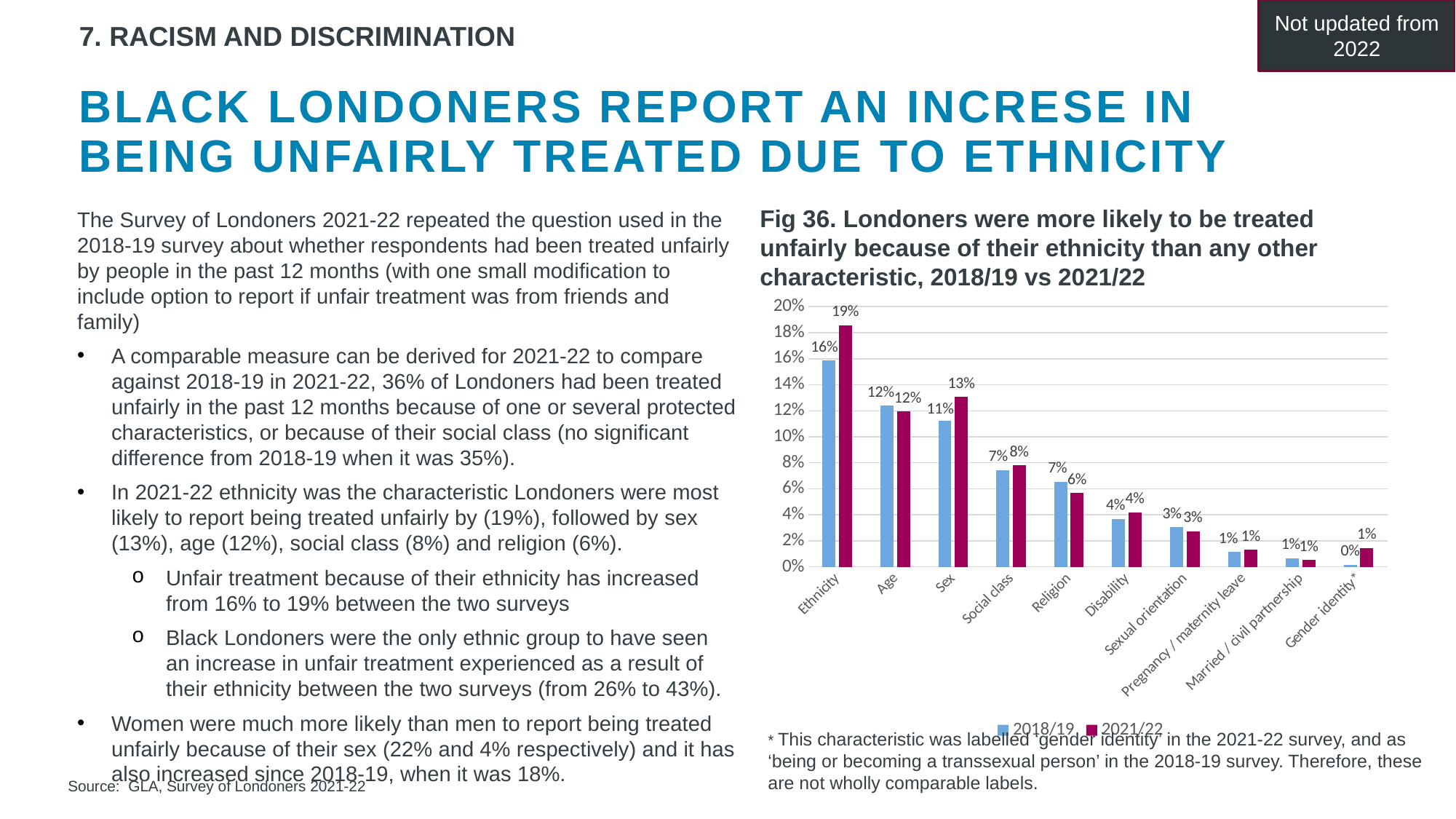
Which characteristic has the highest 2021/22 value in Fig 36? Ethnicity How many characteristics are shown on the x axis of Fig 36? 10 Which characteristic has the lowest 2018/19 value in Fig 36? Gender identity* What is the difference between the 2021/22 and 2018/19 values for Ethnicity in Fig 36? 3% What is the 2018/19 value for Sex in Fig 36? 11% In Fig 36, is the 2018/19 value for Ethnicity greater or less than 14%? greater Which series in Fig 36 is shown in dark red/magenta? 2021/22 What type of chart is Fig 36? bar chart How many series does the legend of Fig 36 list? 2 What is the 2021/22 value for Religion in Fig 36? 6% In Fig 36, is the 2021/22 value for Sex larger or smaller than the 2018/19 value for Sex? larger What is the 2021/22 value for Ethnicity in Fig 36? 19%